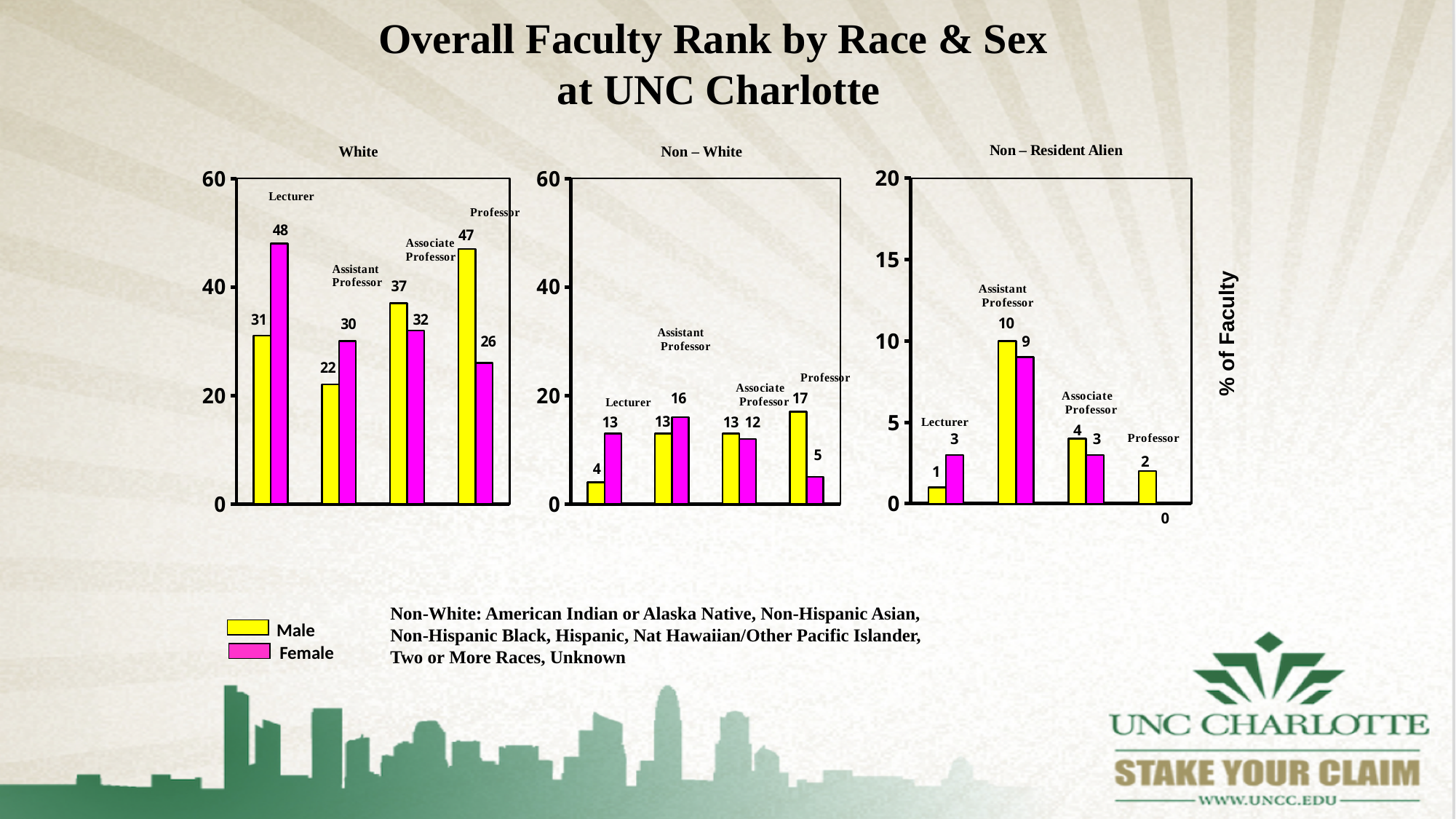
What kind of chart is the White chart? Bar chart In the Non – Resident Alien chart, what is the value for Female Professor? 0 In the White chart, what is the difference between the Male and Female values for Professor? 21 In the White chart, what is the value for Male Professor? 47 How many faculty ranks are shown in the Non – White chart? 4 In the Non – Resident Alien chart, which rank has the lowest Male value? Lecturer In the Non – Resident Alien chart, is the Male Assistant Professor value greater or less than 5? greater In the White chart, what is the value for Female Lecturer? 48 In the Non – White chart, what is the value for Male Lecturer? 4 How many series does the legend list? 2 In the Non – White chart, which is larger for Assistant Professor, the Male or the Female value? Female In the White chart, which rank has the highest Male value? Professor